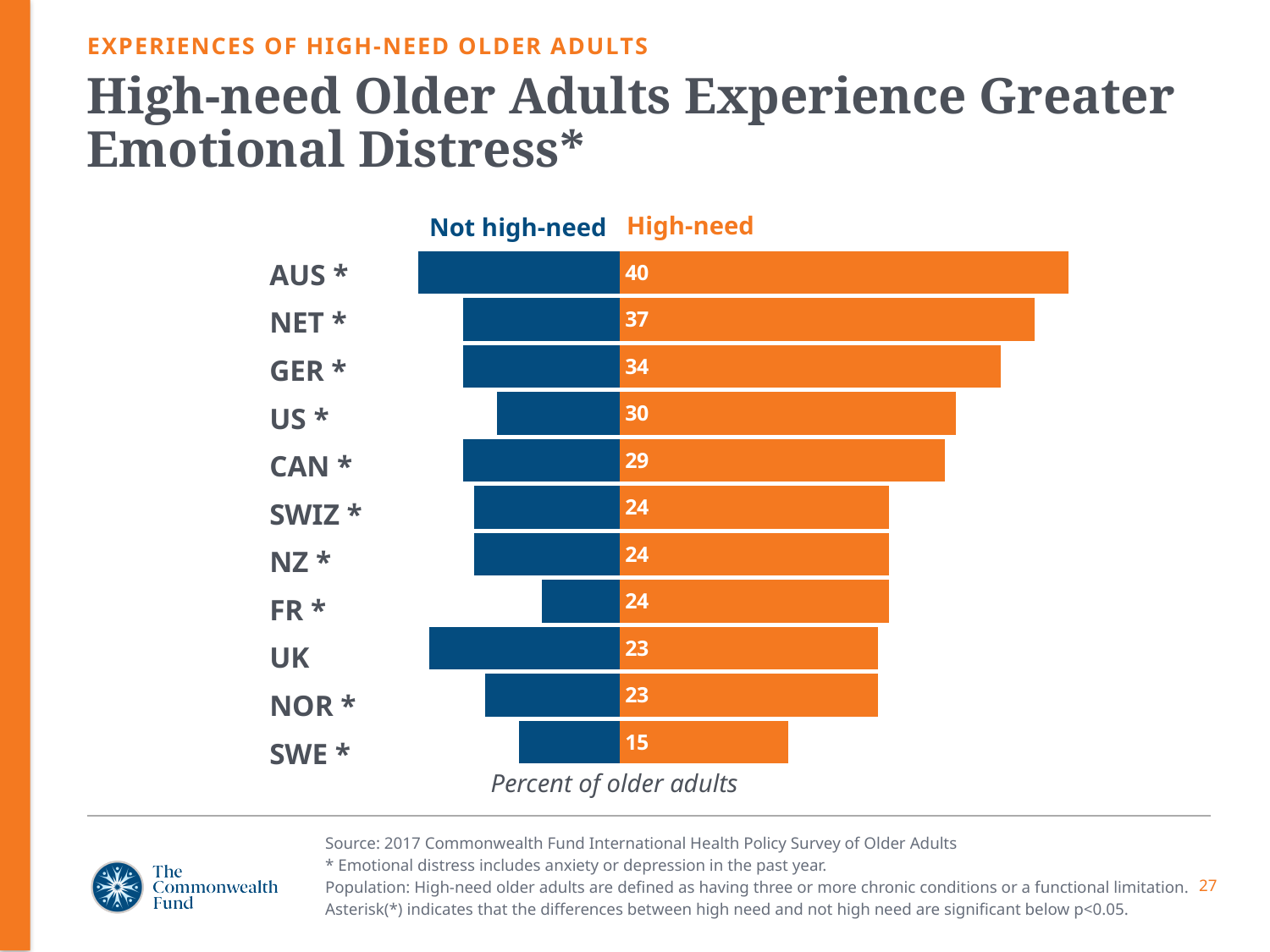
Which country has the lowest High-need value? SWE What is the High-need value for US? 30 Which country has the highest High-need value? AUS Which has a larger High-need value, US or NOR? US What is the High-need value for CAN? 29 What is the High-need value for AUS? 40 What type of chart is shown on the slide? Bar chart What is the difference between the High-need values for AUS and SWE? 25 How many countries are shown in the chart? 11 What is the difference between the High-need values for NET and GER? 3 How many series does the chart show? 2 What is the High-need value for SWE? 15